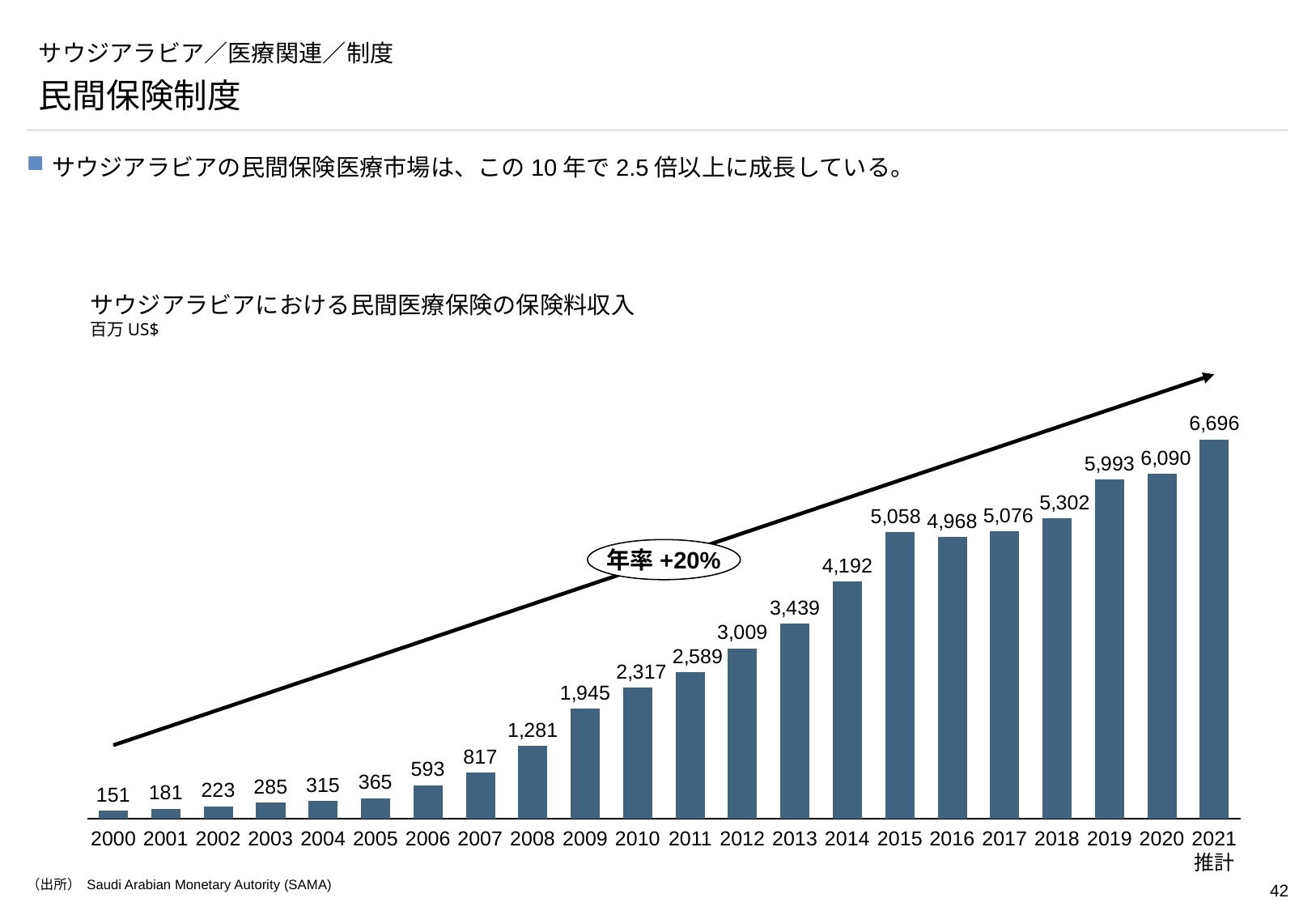
What is the value for 2010? 2,317 What annual growth rate is written in the oval annotation on the chart? 年率 +20% What is the value for 2008? 1,281 What is the difference between the values for 2021 and 2020? 606 What is the value for 2021 (推計)? 6,696 Do the values generally rise or fall from 2000 to 2021? Rise What is the difference between the values for 2015 and 2016? 90 How many years (bars) are shown in the chart? 22 Which is larger, the value for 2015 or the value for 2017? 2017 Which year has the lowest value? 2000 What kind of chart is shown on the slide? Bar chart Which year has the highest value? 2021